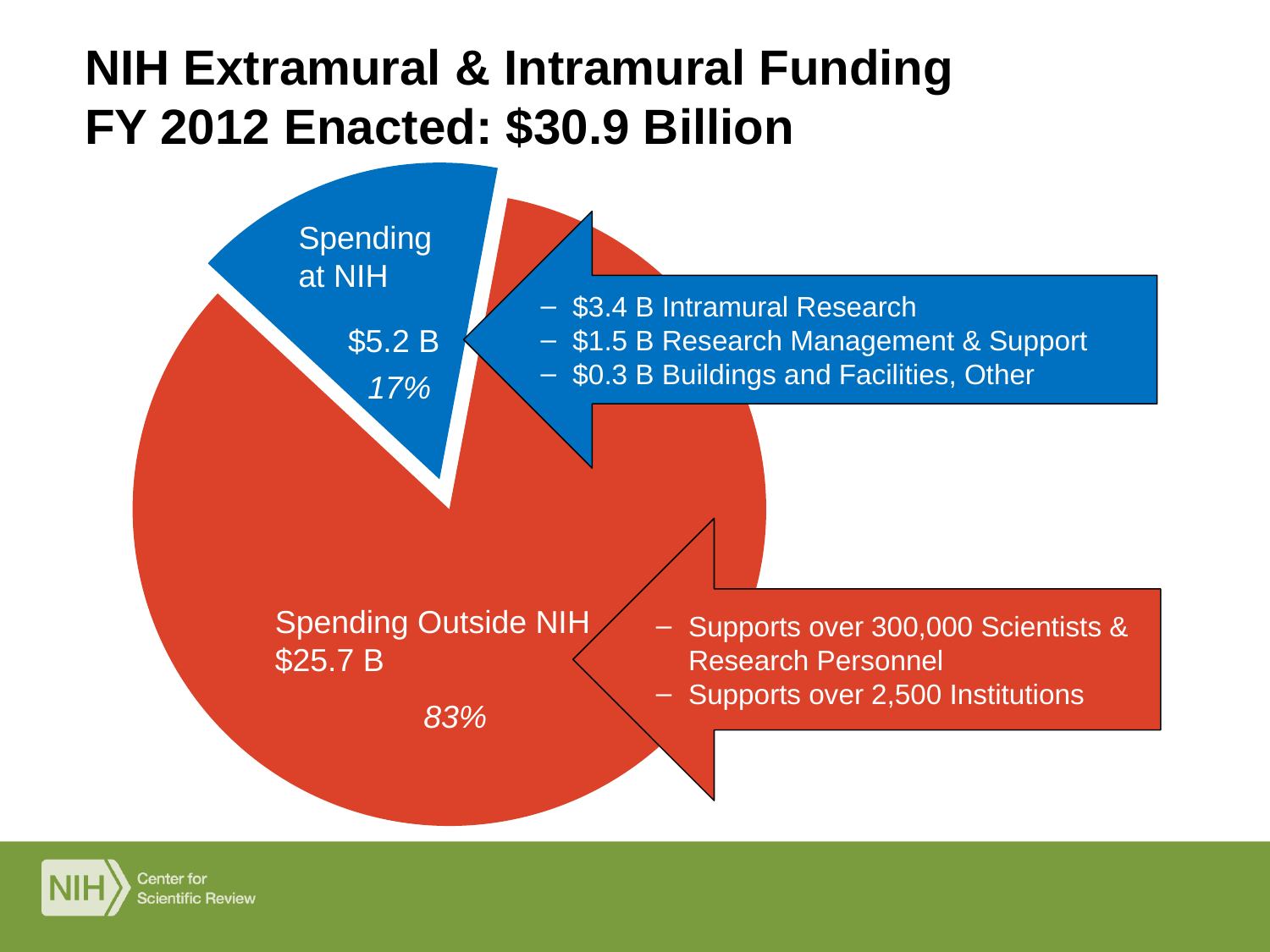
What kind of chart is shown on the slide? Pie chart How many slices does the pie chart have? 2 What is the value for Spending Outside NIH? $25.7 B What share of the pie is Spending at NIH? 17% What colour is the Spending at NIH slice? Blue Which slice is the smallest? Spending at NIH Which slice is the largest? Spending Outside NIH What share of the pie is Spending Outside NIH? 83% What is the value for Spending at NIH? $5.2 B What is the difference between Spending Outside NIH and Spending at NIH? $20.5 B Which is larger, Spending at NIH or Spending Outside NIH? Spending Outside NIH What is the title of the chart? NIH Extramural & Intramural Funding FY 2012 Enacted: $30.9 Billion